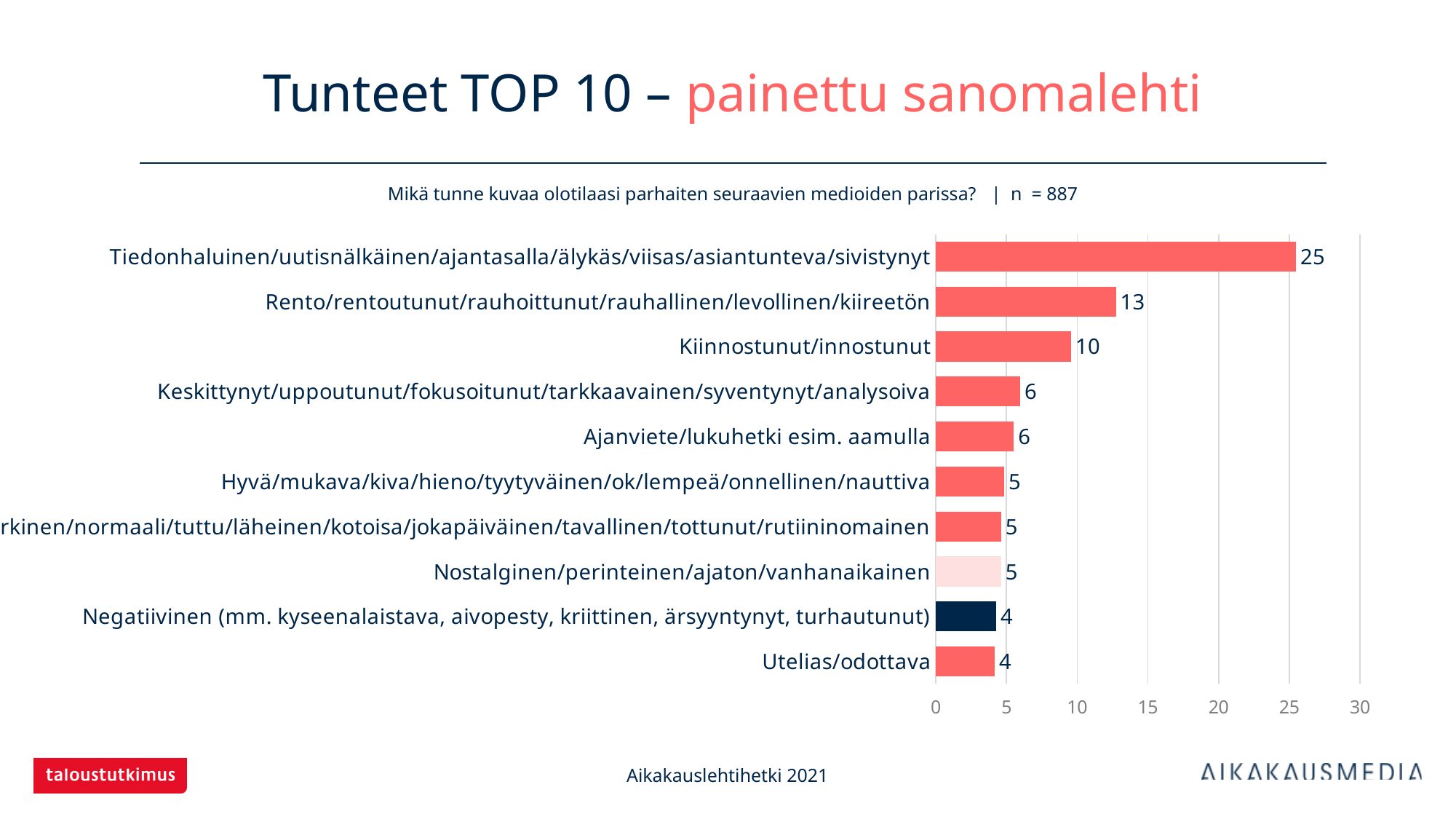
How many categories does the chart show? 10 What is the value for Tiedonhaluinen/uutisnälkäinen/ajantasalla/älykäs/viisas/asiantunteva/sivistynyt? 25 Which category has the highest value? Tiedonhaluinen/uutisnälkäinen/ajantasalla/älykäs/viisas/asiantunteva/sivistynyt What kind of chart is shown on the slide? bar chart Which bar is coloured dark navy instead of red? Negatiivinen (mm. kyseenalaistava, aivopesty, kriittinen, ärsyyntynyt, turhautunut) What is the value for Kiinnostunut/innostunut? 10 Which is larger, the value for Kiinnostunut/innostunut or the value for Ajanviete/lukuhetki esim. aamulla? Kiinnostunut/innostunut What is the value for Negatiivinen (mm. kyseenalaistava, aivopesty, kriittinen, ärsyyntynyt, turhautunut)? 4 What is the value for Rento/rentoutunut/rauhoittunut/rauhallinen/levollinen/kiireetön? 13 What is the difference between the values for Tiedonhaluinen/uutisnälkäinen/ajantasalla/älykäs/viisas/asiantunteva/sivistynyt and Rento/rentoutunut/rauhoittunut/rauhallinen/levollinen/kiireetön? 12 What is the sample size (n) stated on the slide? 887 What is the value for Nostalginen/perinteinen/ajaton/vanhanaikainen? 5